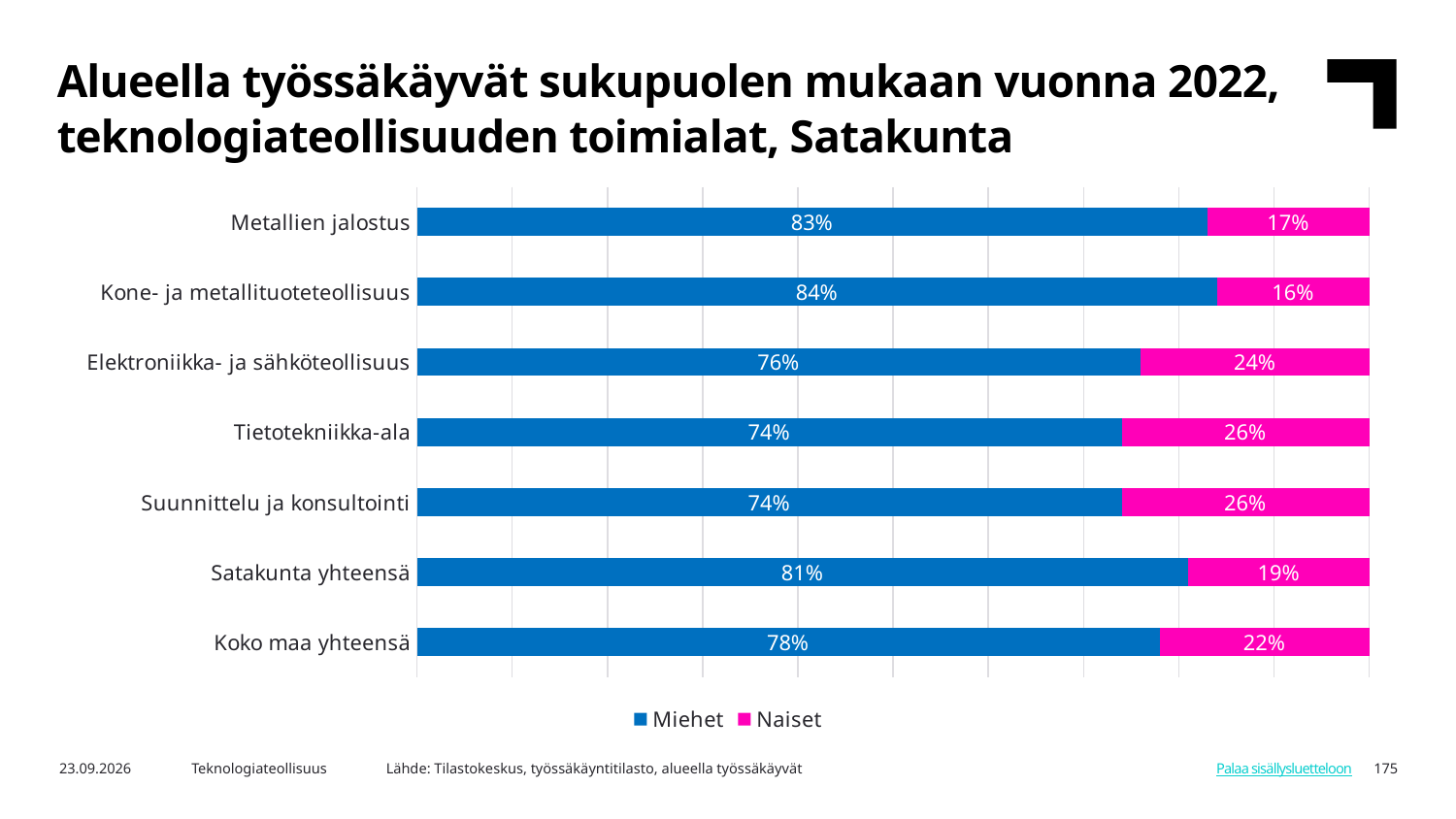
What is the Naiset share for Koko maa yhteensä? 22% What is the Naiset share for Elektroniikka- ja sähköteollisuus? 24% How many series does the legend list? 2 What is the total of the stacked bar for Suunnittelu ja konsultointi? 100% Which category has the lowest Naiset share? Kone- ja metallituoteteollisuus What is the difference between the Naiset share for Tietotekniikka-ala and the Naiset share for Metallien jalostus? 9 percentage points Which colour represents Naiset in the chart? Magenta (pink) Which is larger: the Miehet share for Satakunta yhteensä or the Miehet share for Koko maa yhteensä? Satakunta yhteensä Which category has the highest Miehet share? Kone- ja metallituoteteollisuus What kind of chart is shown on the slide? Stacked bar chart What is the Miehet share for Metallien jalostus? 83% How many categories are shown on the chart? 7